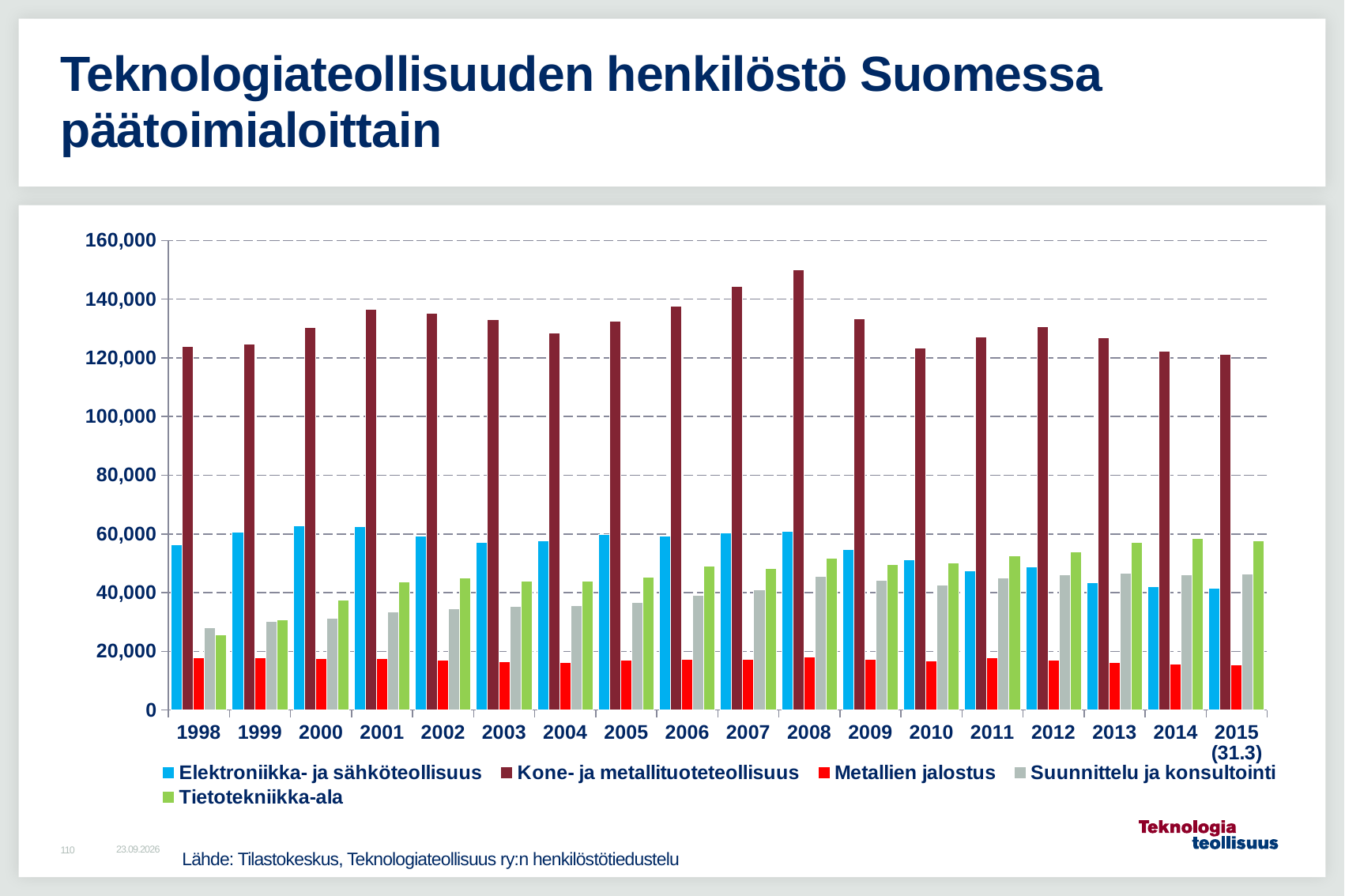
Is the value for Kone- ja metallituoteteollisuus in 2008 greater or less than 140,000? greater How many years are shown on the x axis? 18 Is the value for Elektroniikka- ja sähköteollisuus in 2015 (31.3) greater or less than 60,000? less Which series is shown in dark red in the legend? Kone- ja metallituoteteollisuus Is the value for Tietotekniikka-ala in 1998 greater or less than 40,000? less In 2015 (31.3), which is larger: Tietotekniikka-ala or Elektroniikka- ja sähköteollisuus? Tietotekniikka-ala In which year is the value for Kone- ja metallituoteteollisuus highest? 2008 What kind of chart is shown on the slide? bar chart In which year is the value for Tietotekniikka-ala lowest? 1998 How many series does the legend list? 5 Does the value for Tietotekniikka-ala generally rise or fall from 1998 to 2015? rise